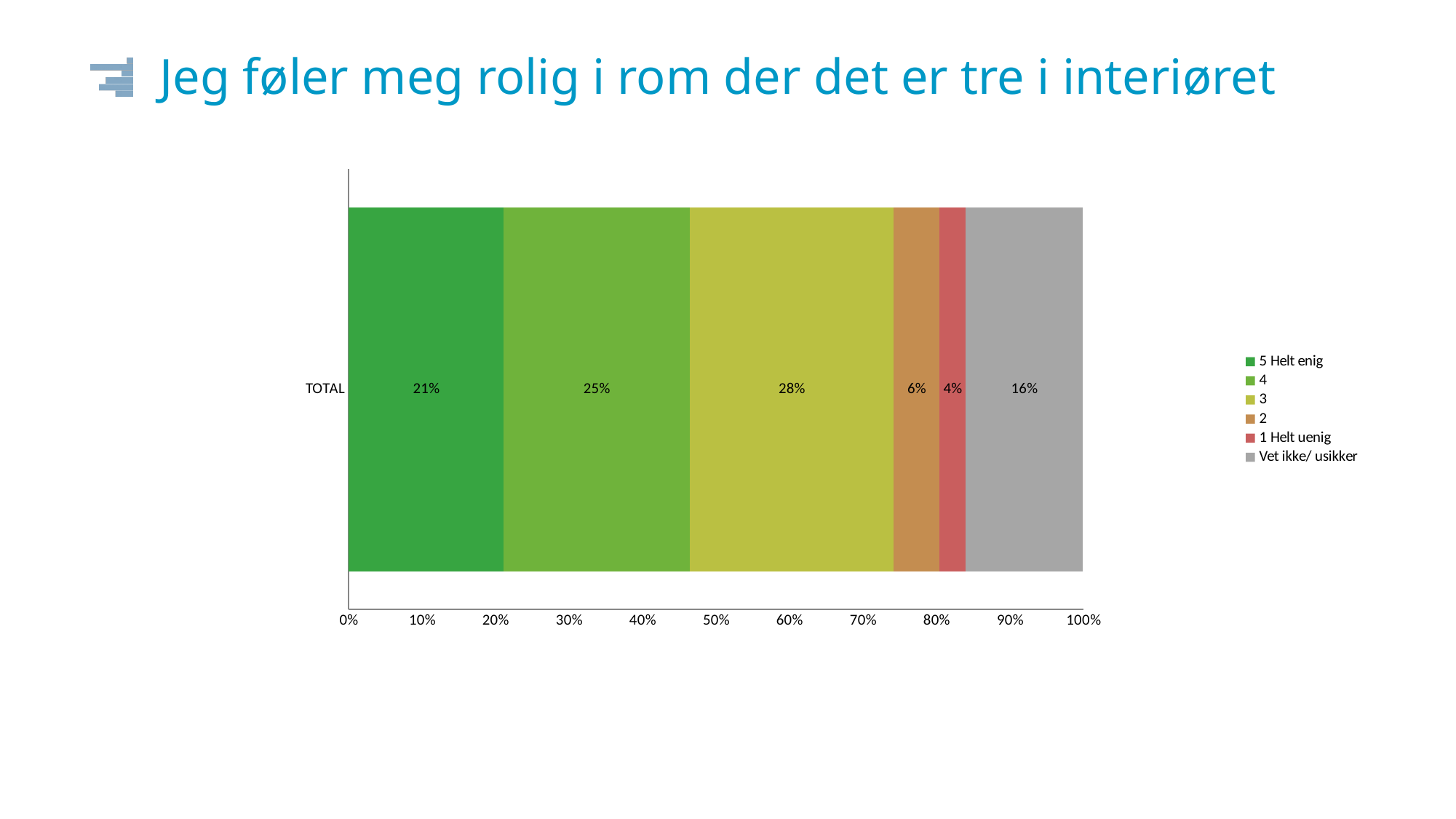
What kind of chart is shown on the slide? Stacked bar chart Which response category has the smallest share? 1 Helt uenig What percentage of respondents answered "3"? 28% Which is larger, the share for "4" or the share for "Vet ikke/ usikker"? 4 What is the title of the slide? Jeg føler meg rolig i rom der det er tre i interiøret What percentage of respondents answered "Vet ikke/ usikker"? 16% What percentage of respondents answered "5 Helt enig"? 21% Which response category has the largest share? 3 What percentage of respondents answered "4"? 25% What is the difference between the share for "3" and the share for "5 Helt enig"? 7% What percentage of respondents answered "1 Helt uenig"? 4% How many series does the legend list? 6